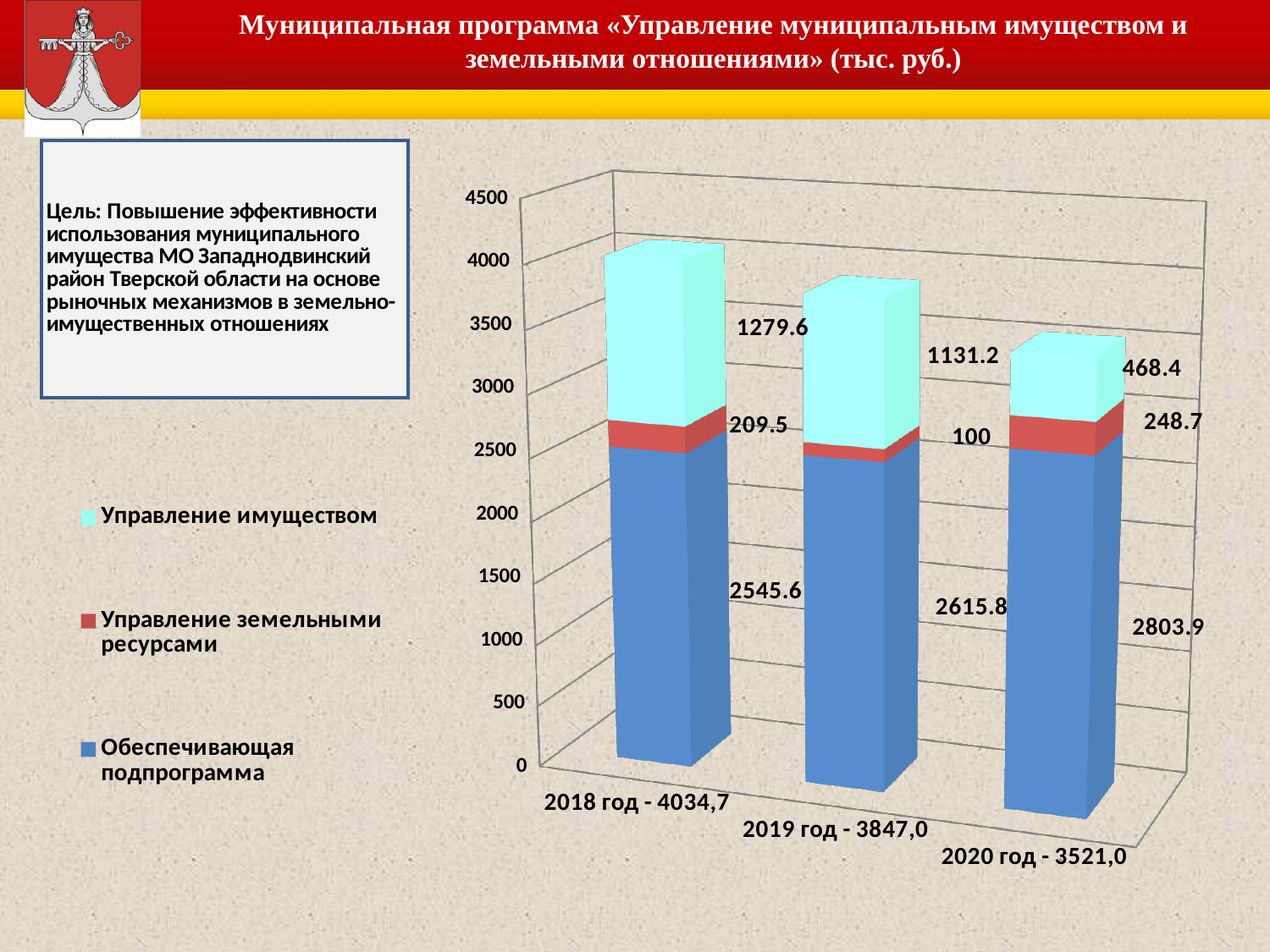
What is the value of «Управление имуществом» for 2018? 1279.6 How many series does the legend list? 3 How many categories (years) are shown on the x axis? 3 What is the total of the stacked bar for 2019, as printed in its axis label? 3847,0 In which year is the value of «Обеспечивающая подпрограмма» the highest? 2020 Which is larger: «Управление земельными ресурсами» in 2018 or in 2020? 2020 Do the total values of the stacked bars rise or fall from 2018 to 2020? Fall In which year is the value of «Управление имуществом» the lowest? 2020 What is the difference between the «Обеспечивающая подпрограмма» values for 2020 and 2018? 258.3 What is the value of «Управление земельными ресурсами» for 2019? 100 What type of chart is shown on the slide? Stacked bar chart What is the value of «Обеспечивающая подпрограмма» for 2020? 2803.9